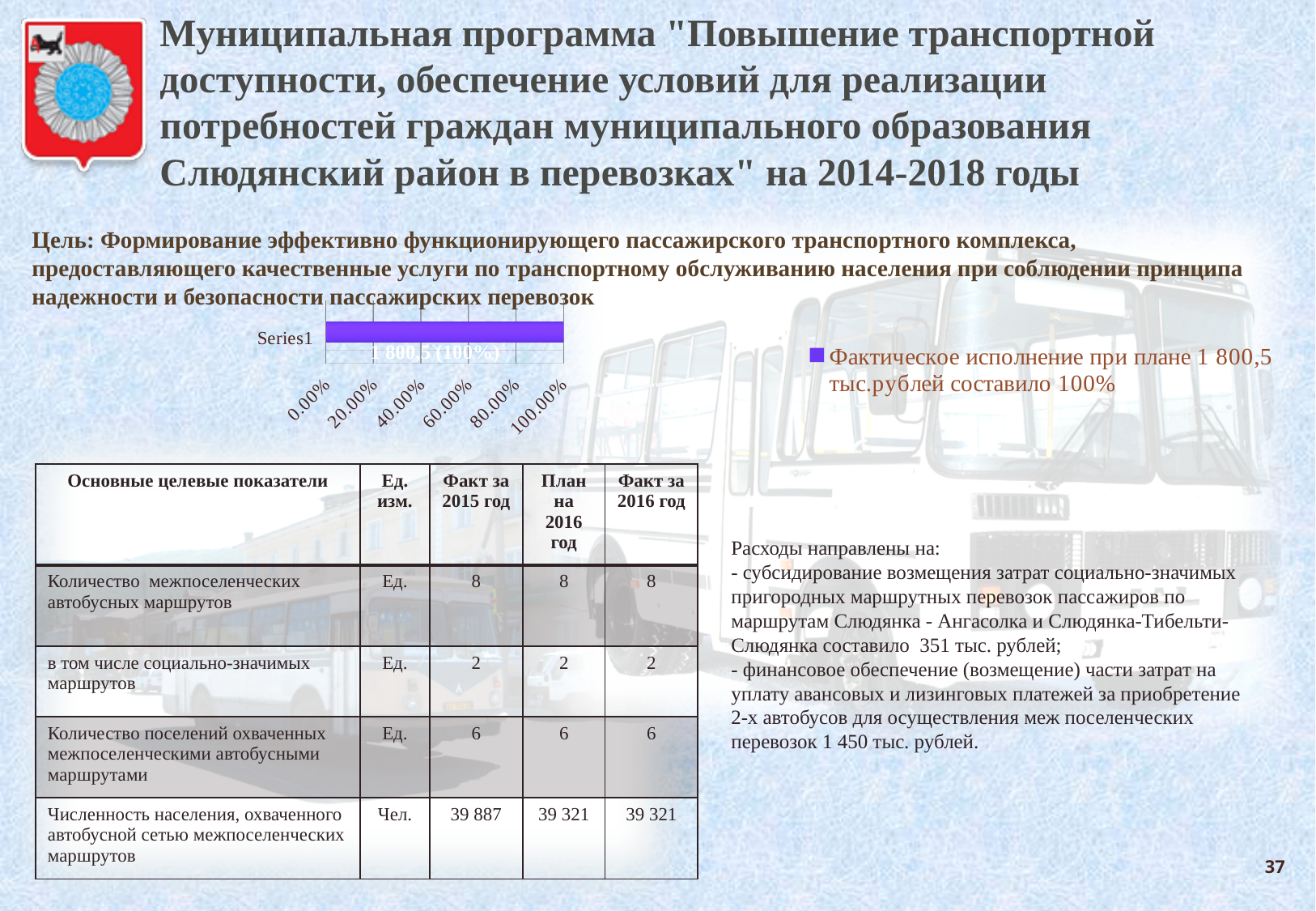
What percentage does the Series1 bar reach according to its data label? 100% What kind of chart is shown on the slide? bar chart What is the category label shown on the chart's y axis? Series1 How many series does the chart's legend list? 1 What is the highest tick label shown on the chart's x axis? 100.00% What is the data label printed on the Series1 bar? 1 800,5 (100%) Is the value for Series1 greater or less than 80.00%? greater Is the value for Series1 greater or less than 60.00%? greater How many bars does the chart contain? 1